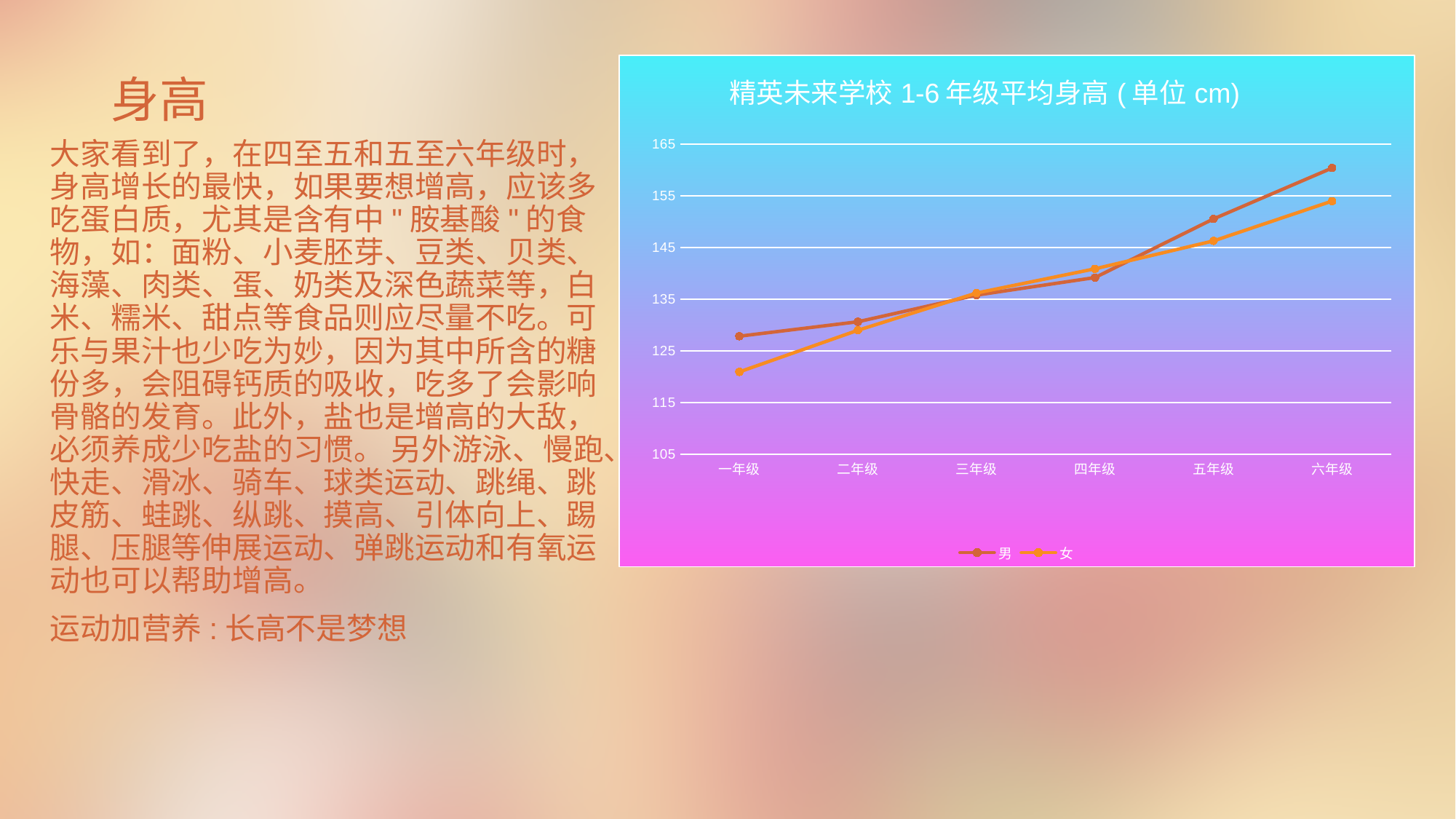
At 一年级, which series has the larger value, 男 or 女? 男 Is the value for 男 at 五年级 greater or less than 145? greater At which grade is the value for 女 lowest? 一年级 Is the value for 女 at 一年级 greater or less than 125? less How many series does the legend list? 2 How many grade categories are plotted on the x axis? 6 What kind of chart is shown on the slide? line chart At 六年级, which series has the larger value, 男 or 女? 男 What is the title of the chart? 精英未来学校 1-6 年级平均身高 ( 单位 cm) At which grade is the value for 男 highest? 六年级 Is the value for 男 at 六年级 greater or less than 155? greater Do the values for 男 rise or fall from 一年级 to 六年级? rise